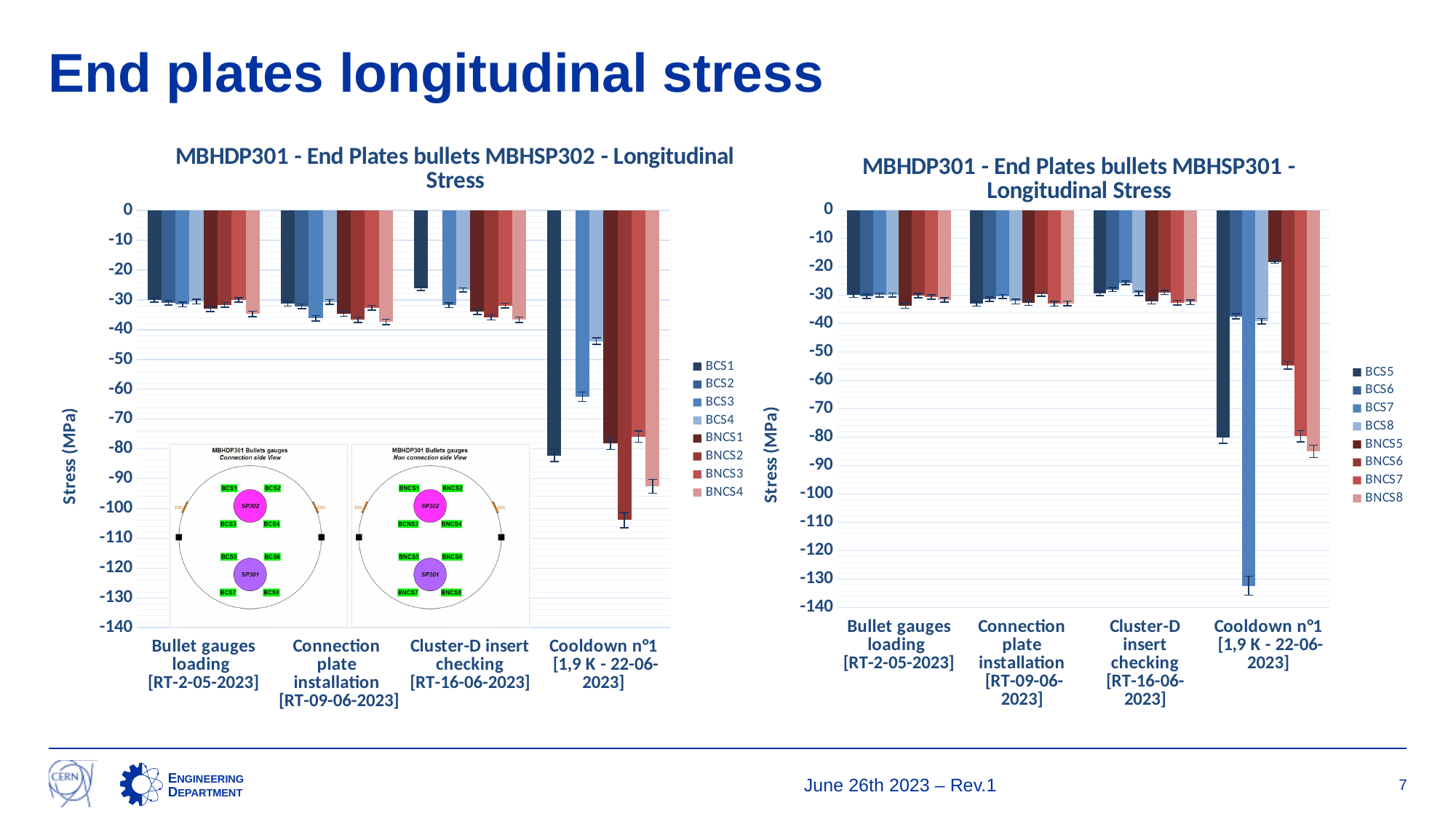
In the left chart (MBHSP302 - Longitudinal Stress), how many categories are shown on the x axis? 4 What kind of chart is used on this slide for the longitudinal stress data? Bar chart In the right chart (MBHSP301 - Longitudinal Stress), is the value for BCS6 in the Cooldown n°1 category greater or less than -100? greater In the right chart (MBHSP301 - Longitudinal Stress), which series has the lowest (most negative) value in the Cooldown n°1 category? BCS7 In the left chart (MBHSP302 - Longitudinal Stress), how many series does the legend list? 8 What is the y-axis label of the charts on this slide? Stress (MPa) In the left chart (MBHSP302 - Longitudinal Stress), is the value for BCS1 in the Cooldown n°1 category greater or less than -60? less In the right chart (MBHSP301 - Longitudinal Stress), is the value for BCS8 in the Cooldown n°1 category greater or less than -30? less In the right chart (MBHSP301 - Longitudinal Stress), how many series does the legend list? 8 In the right chart (MBHSP301 - Longitudinal Stress), in the Cooldown n°1 category, which series has the more negative value, BCS5 or BNCS5? BCS5 In the right chart (MBHSP301 - Longitudinal Stress), how many categories are shown on the x axis? 4